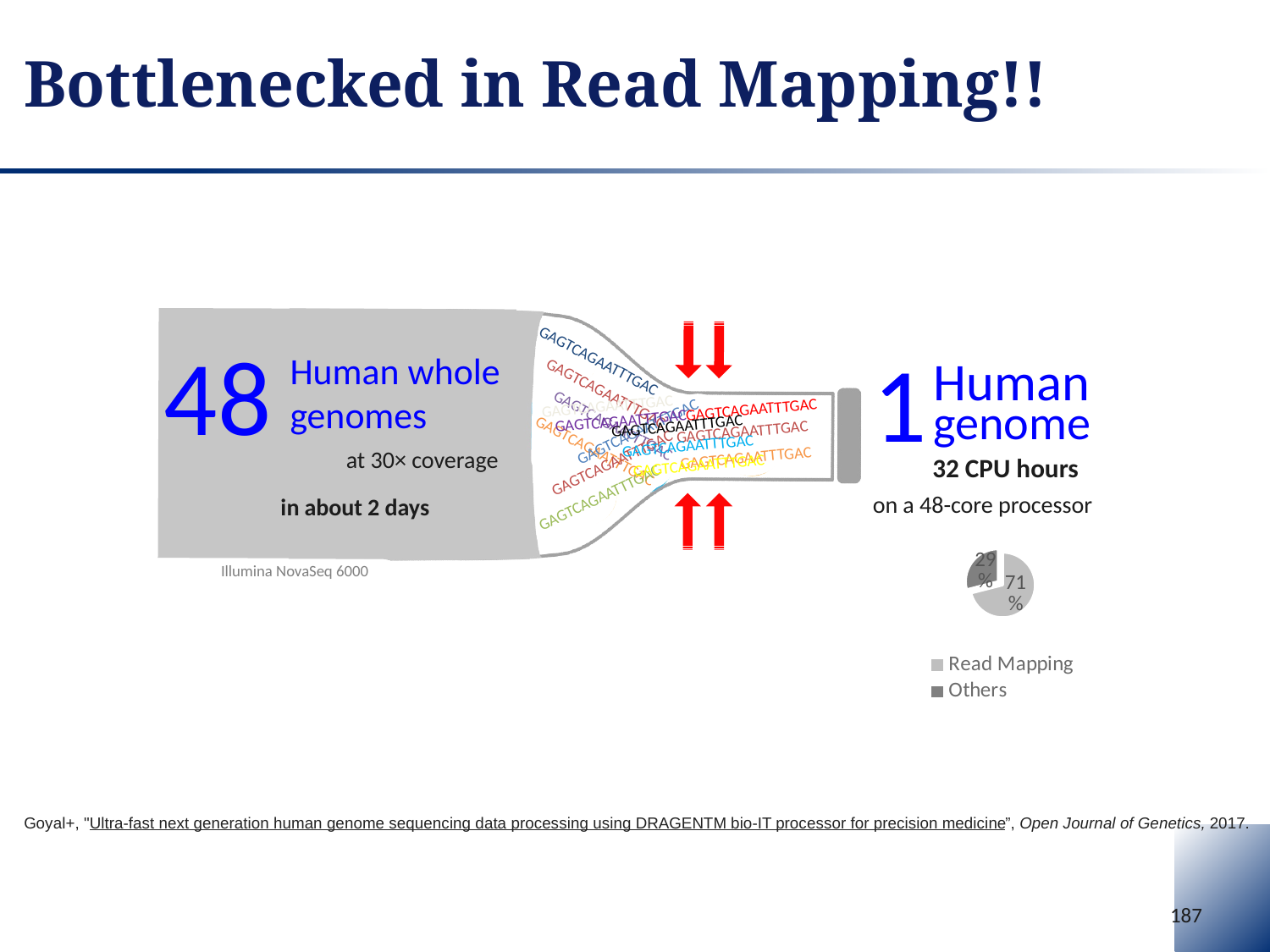
What do the two slice percentages on the pie chart add up to? 100% What is the difference between the two slice percentages on the pie chart? 42% How many slices does the pie chart have? 2 What is the smallest percentage shown on the pie chart? 29% What is the largest percentage shown on the pie chart? 71% How many series does the legend of the pie chart list? 2 Is the smaller slice of the pie chart greater or less than 50%? less Which entries are listed in the legend of the pie chart? Read Mapping, Others What kind of chart is shown on the slide? pie chart Is the larger slice of the pie chart greater or less than 50%? greater